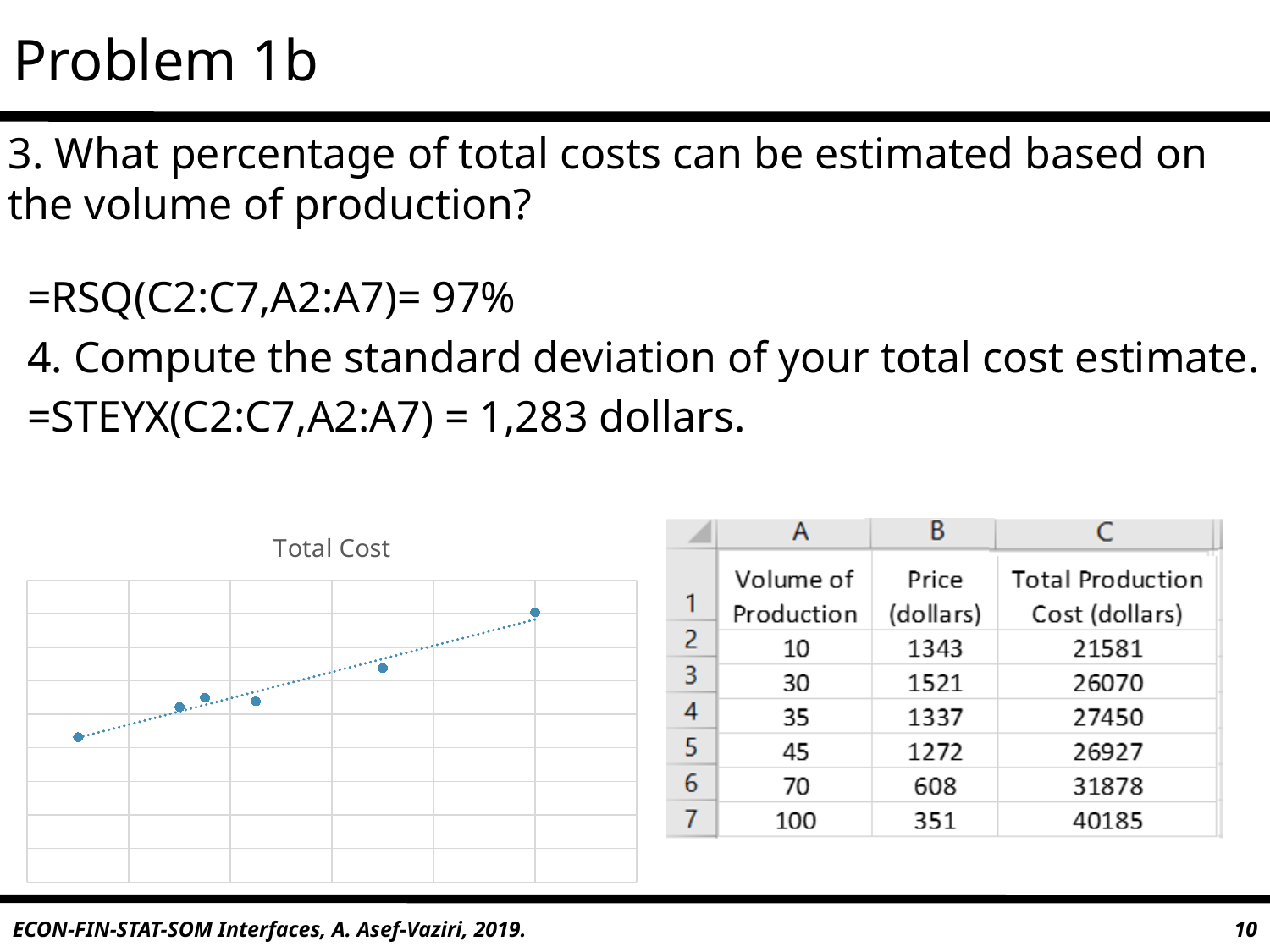
What is the title of the chart on the slide? Total Cost According to the table on the slide, which Volume of Production has the lowest Total Production Cost? 10 According to the table on the slide, which has the larger Total Production Cost: a volume of 30 or a volume of 45? 45 What style of line is drawn through the points in the "Total Cost" chart? dotted trendline According to the table on the slide, what is the Total Production Cost (dollars) for a Volume of Production of 100? 40185 According to the table on the slide, what is the Total Production Cost (dollars) for a Volume of Production of 10? 21581 Do the points in the "Total Cost" chart generally rise or fall from left to right? rise How many data points are plotted in the "Total Cost" chart? 6 According to the table on the slide, which Volume of Production has the highest Total Production Cost? 100 Using the table on the slide, what is the difference in Total Production Cost between a volume of 100 and a volume of 10? 18604 What kind of chart is the "Total Cost" chart on the slide? scatter chart According to the table on the slide, what is the Price (dollars) at a Volume of Production of 70? 608